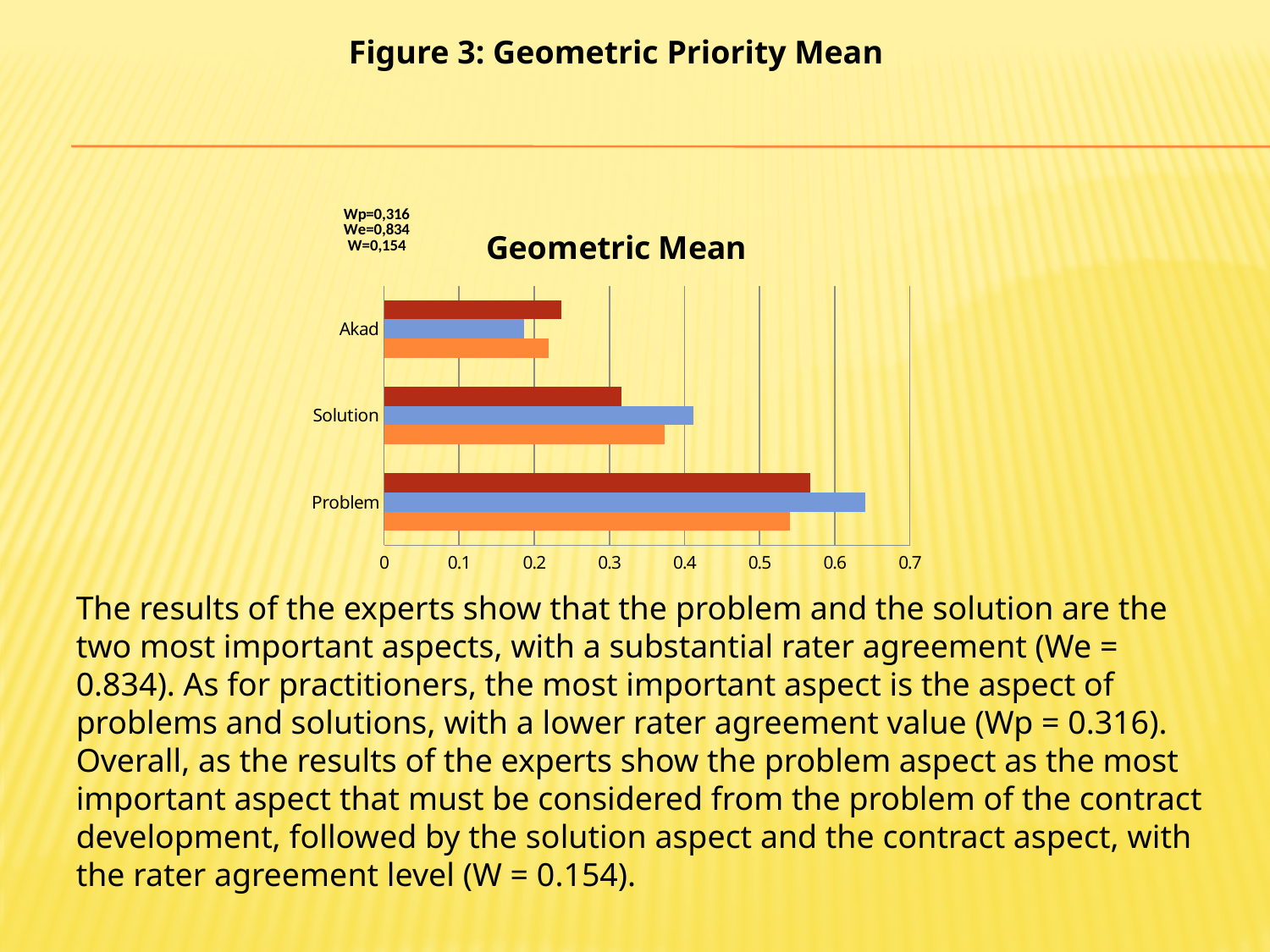
Is the blue bar for Problem greater or less than 0.6? greater For the Problem category, which is longer: the blue bar or the dark red bar? the blue bar Is the dark red bar for Akad greater or less than 0.3? less Is the blue bar for Solution greater or less than 0.3? greater What type of chart is shown on the slide? bar chart Do the values increase or decrease going from Akad to Solution to Problem? increase What is the title of the chart? Geometric Mean Which category has the lowest values in the Geometric Mean chart? Akad Which category has the highest values in the Geometric Mean chart? Problem How many categories are shown on the vertical axis of the Geometric Mean chart? 3 For the Solution category, which is longer: the blue bar or the dark red bar? the blue bar